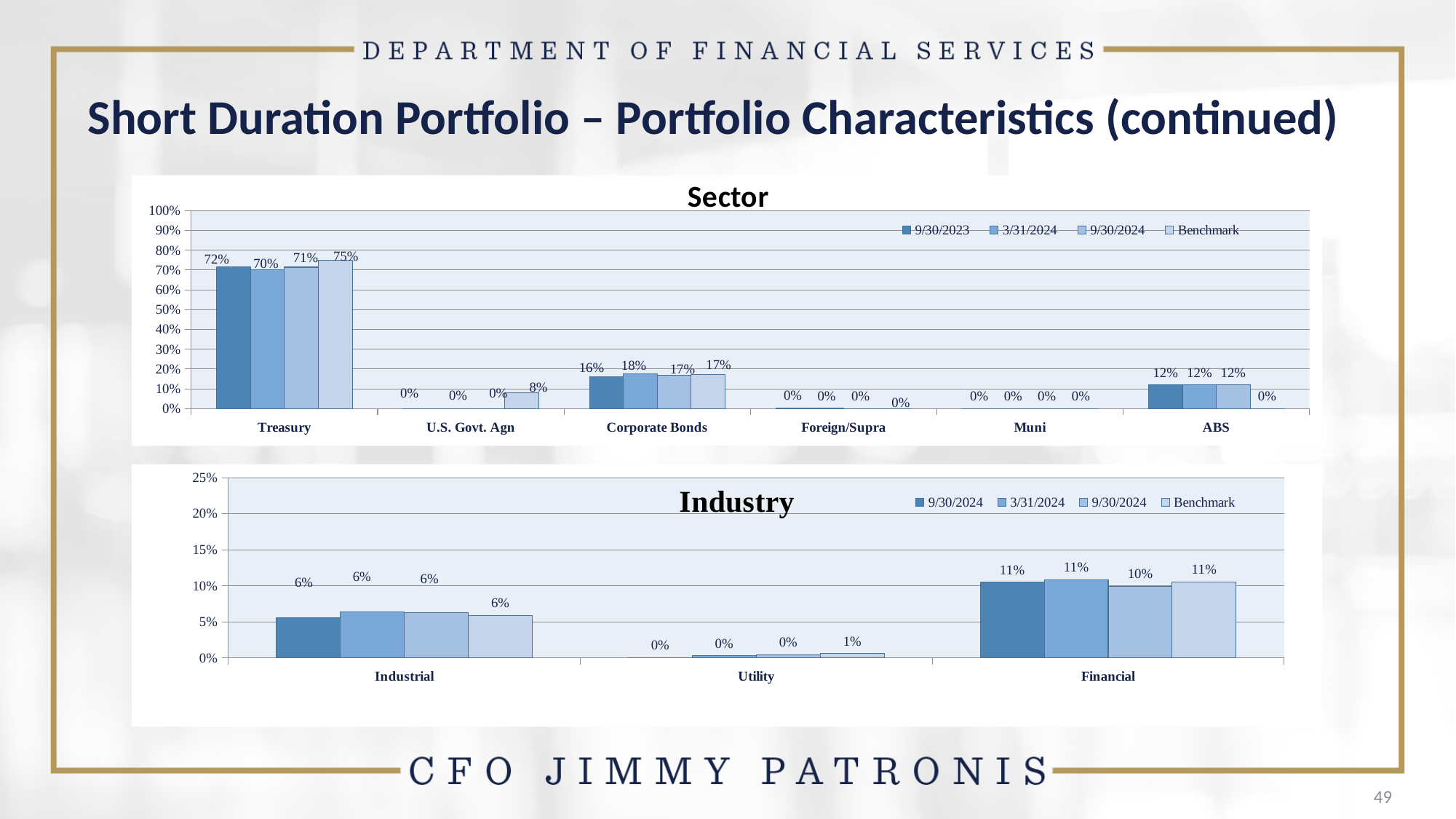
In the Sector chart, what is the 3/31/2024 value for Corporate Bonds? 18% In the Sector chart, what is the difference between the Benchmark value and the 9/30/2023 value for Treasury? 3% In the Sector chart, is the 9/30/2024 value for ABS larger or smaller than the Benchmark value for ABS? larger How many series does the legend of the Sector chart list? 4 In the Sector chart, what is the Benchmark value for U.S. Govt. Agn? 8% In the Industry chart, what is the Benchmark value for Utility? 1% How many categories are shown on the x axis of the Sector chart? 6 In the Sector chart, what is the Benchmark value for Treasury? 75% What kind of chart is the Industry chart? bar chart How many categories are shown on the x axis of the Industry chart? 3 In the Sector chart, which category has the highest 9/30/2024 value? Treasury In the Industry chart, which category has the highest Benchmark value? Financial